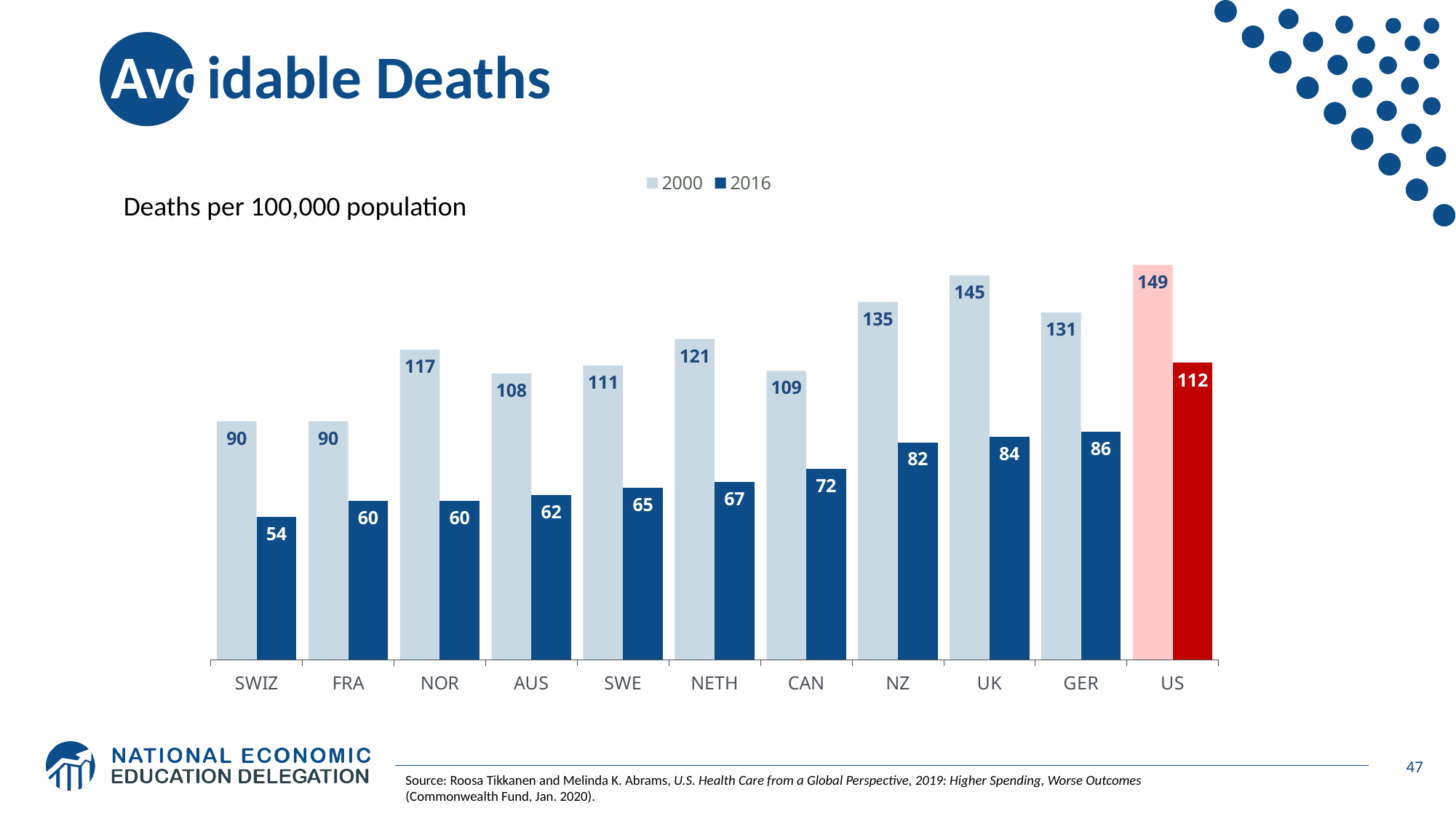
Which is larger: the 2016 value for the UK or the 2016 value for Germany (GER)? GER Which country had the highest value in 2000? US What was the value for the US in 2016? 112 What kind of chart is shown on the slide? Bar chart What is the difference between the US values for 2000 and 2016? 37 What was the value for Canada (CAN) in 2016? 72 Which country had the lowest value in 2016? SWIZ How many countries are shown on the x axis? 11 What was the value for Switzerland (SWIZ) in 2000? 90 What is the difference between the 2000 and 2016 values for Norway (NOR)? 57 What unit is the chart measured in, according to the label above it? Deaths per 100,000 population How many series does the legend list? 2